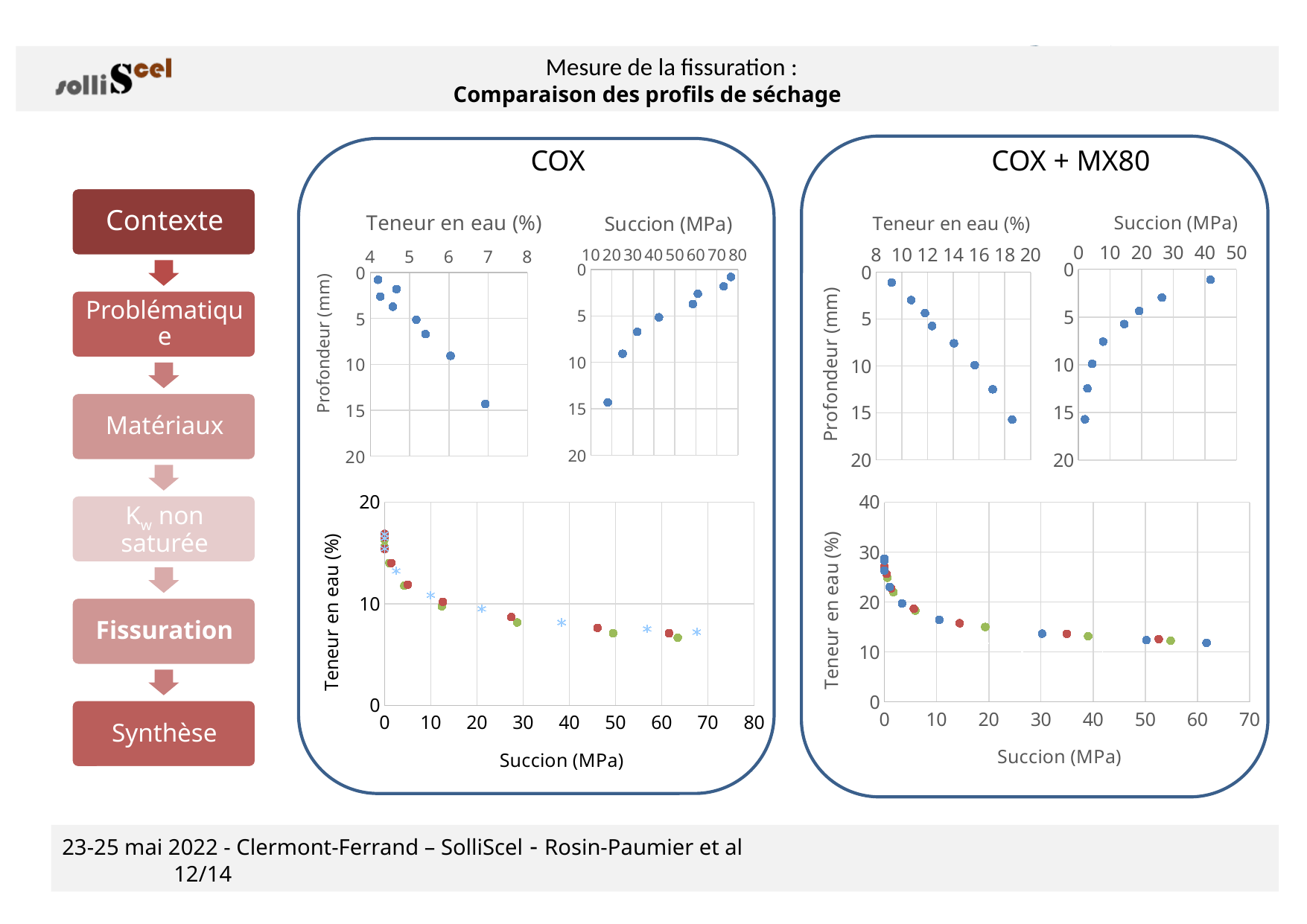
In the bottom chart of the COX panel, is the water content at a suction of 0 MPa greater or less than 10%? greater In the bottom chart of the COX + MX80 panel, does the water content rise or fall as suction increases? fall In the COX + MX80 panel's 'Succion (MPa)' depth profile, is the suction at the shallowest point (near 0 mm depth) greater or less than 30 MPa? greater In the bottom chart of the COX panel, does the water content rise or fall as suction increases? fall What is the y-axis label of the depth profile charts in the COX + MX80 panel? Profondeur (mm) In the COX panel's 'Teneur en eau (%)' depth profile, is the water content at the deepest point (about 14 mm) greater or less than 6%? greater In the bottom chart of the COX panel, which has the larger water content: the point at a suction of 0 MPa or the point at a suction of about 60 MPa? the point at 0 MPa What is the maximum value shown on the x axis (Succion) of the bottom chart in the COX panel? 80 In the COX panel's 'Teneur en eau (%)' depth profile, does the water content rise or fall as depth increases? rise What kind of chart is the bottom chart in the COX panel (Teneur en eau vs Succion)? scatter chart